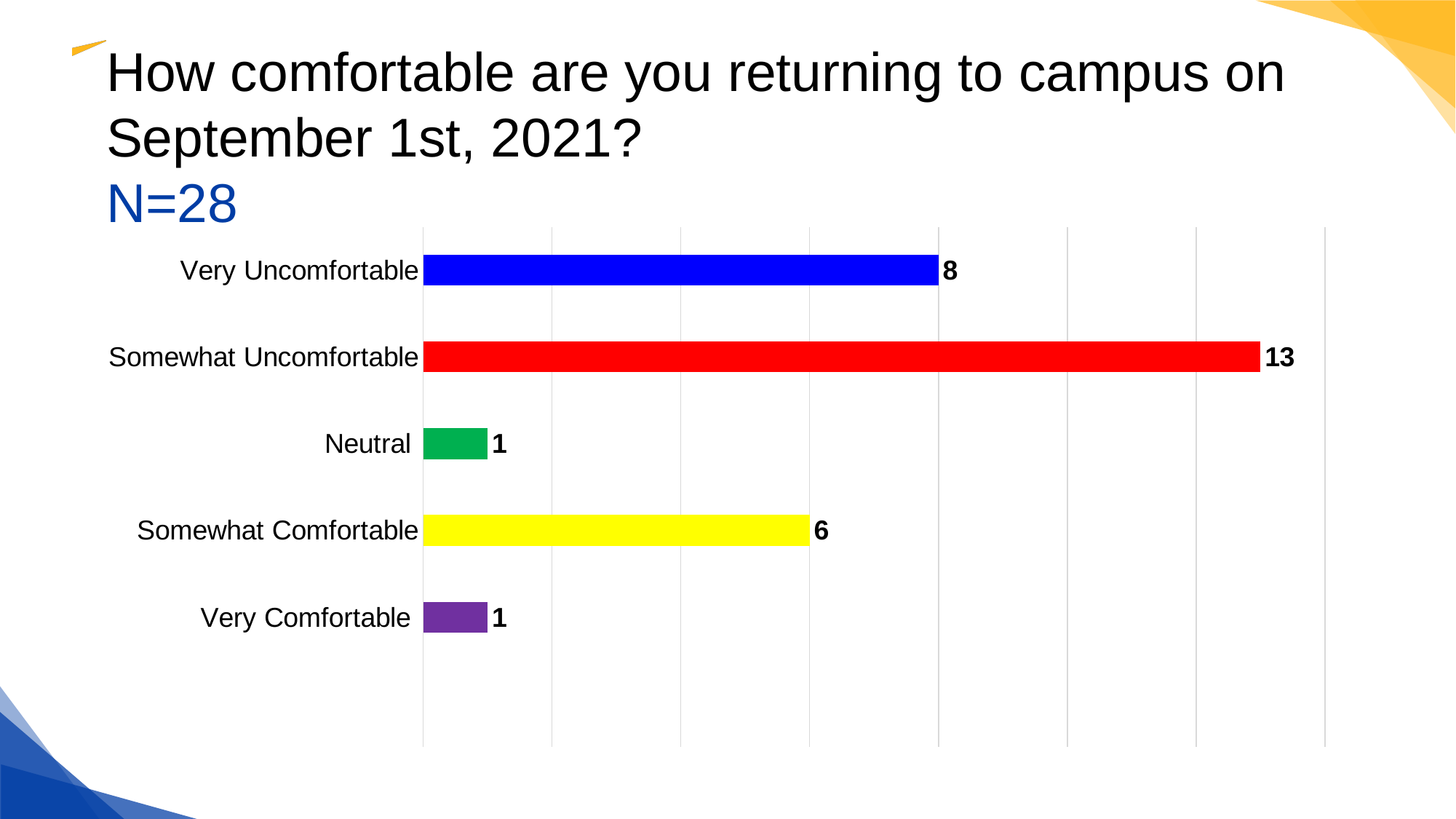
How many categories are shown in the chart? 5 Which category has the highest value? Somewhat Uncomfortable What is the value for Somewhat Comfortable? 6 What is the difference between the values for Very Uncomfortable and Somewhat Comfortable? 2 What kind of chart is shown on the slide? bar chart What is the value for Very Uncomfortable? 8 Which is larger, the value for Very Uncomfortable or the value for Somewhat Comfortable? Very Uncomfortable What is the value for Somewhat Uncomfortable? 13 What colour is the bar for Somewhat Uncomfortable? red What is the value for Neutral? 1 What is the sample size (N) stated on the slide? N=28 What is the difference between the values for Somewhat Uncomfortable and Very Uncomfortable? 5